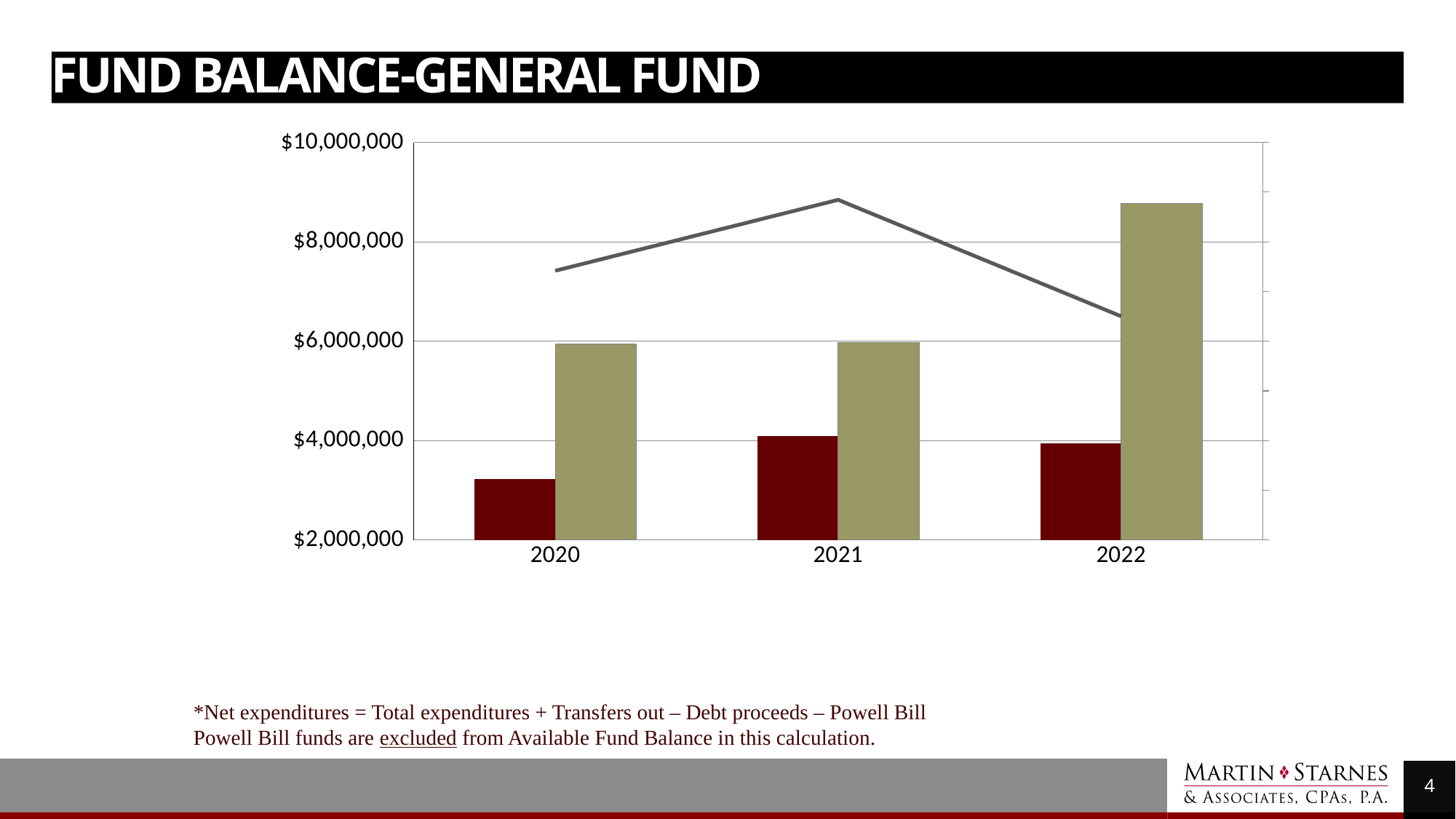
In which year is the olive bar the tallest? 2022 What kind of chart is shown on the slide? Bar chart with a line overlay In which year is the dark red bar the shortest? 2020 How many years are shown on the x axis of the chart? 3 Which is larger in 2020, the dark red bar or the olive bar? The olive bar What is the title of the slide containing the chart? FUND BALANCE-GENERAL FUND Is the value of the dark red bar for 2020 greater or less than $4,000,000? less In which year does the gray line reach its highest point? 2021 Is the value of the olive bar for 2022 greater or less than $8,000,000? greater Does the gray line rise or fall from 2021 to 2022? Fall